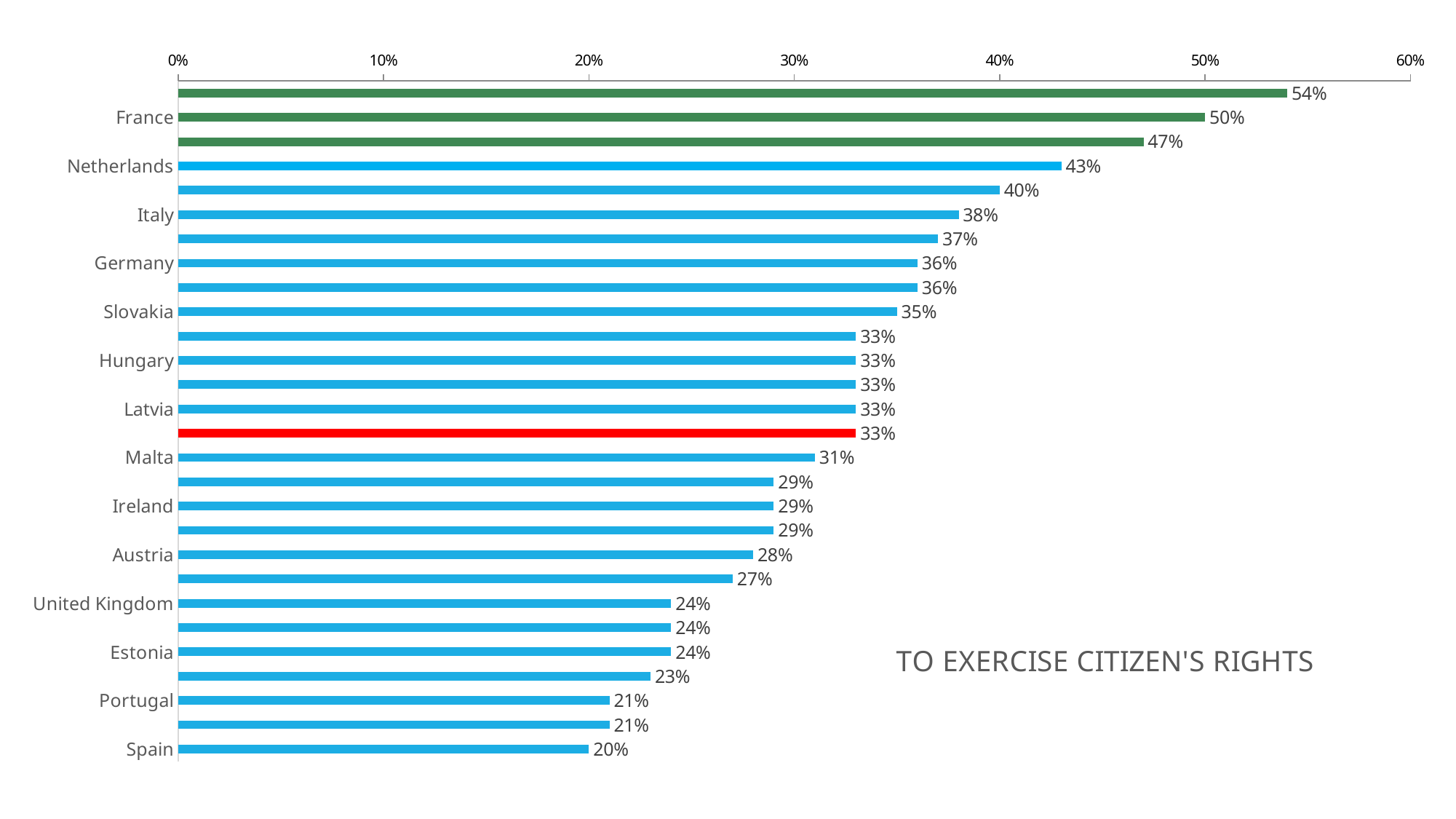
What is the text shown in the lower right of the chart? TO EXERCISE CITIZEN'S RIGHTS How many bars are plotted in the chart? 28 What is the value for Germany? 36% Which has a larger value, Slovakia or Malta? Slovakia What kind of chart is shown on the slide? bar chart What is the value for Netherlands? 43% What is the value for France? 50% What is the difference between the values for France and Italy? 12% What colour is the bar directly below Latvia? red Which labelled country has the lowest value? Spain Is the value for Austria greater or less than 30%? less What is the value for Spain? 20%